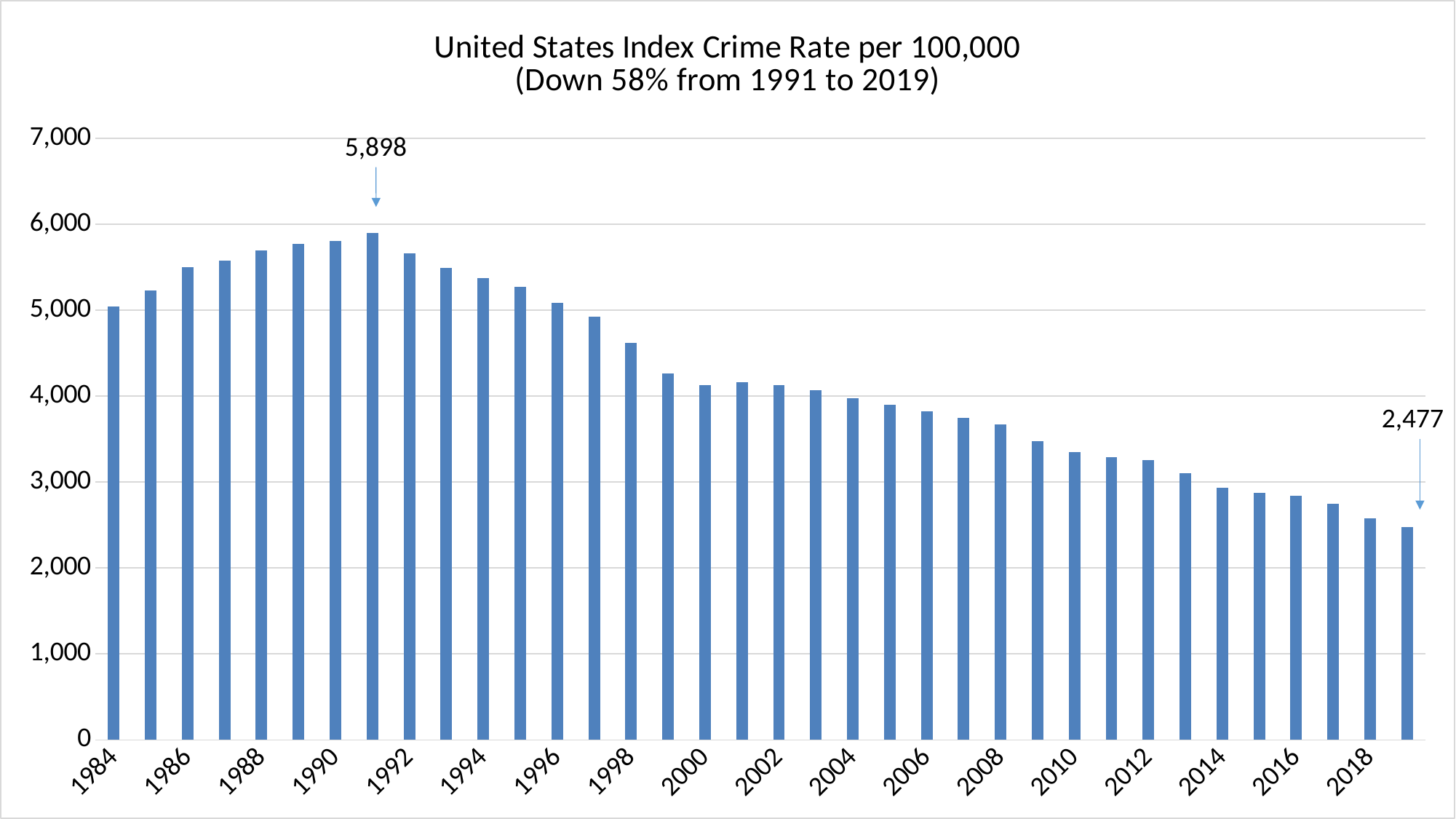
Is the value for 1988 greater or less than 5,000? greater Which year has the larger value, 1991 or 2019? 1991 Is the value for 2010 greater or less than 4,000? less What is the index crime rate per 100,000 shown for 1991? 5,898 Do the values rise or fall from 1991 to 2019? fall What is the index crime rate per 100,000 shown for 2019? 2,477 What is the difference between the 1991 value and the 2019 value? 3,421 Is the value for 1998 greater or less than 4,000? greater Which year has the lowest index crime rate in the chart? 2019 What kind of chart is shown on the slide? bar chart Which year has the highest index crime rate in the chart? 1991 How many years (bars) are plotted in the chart? 36